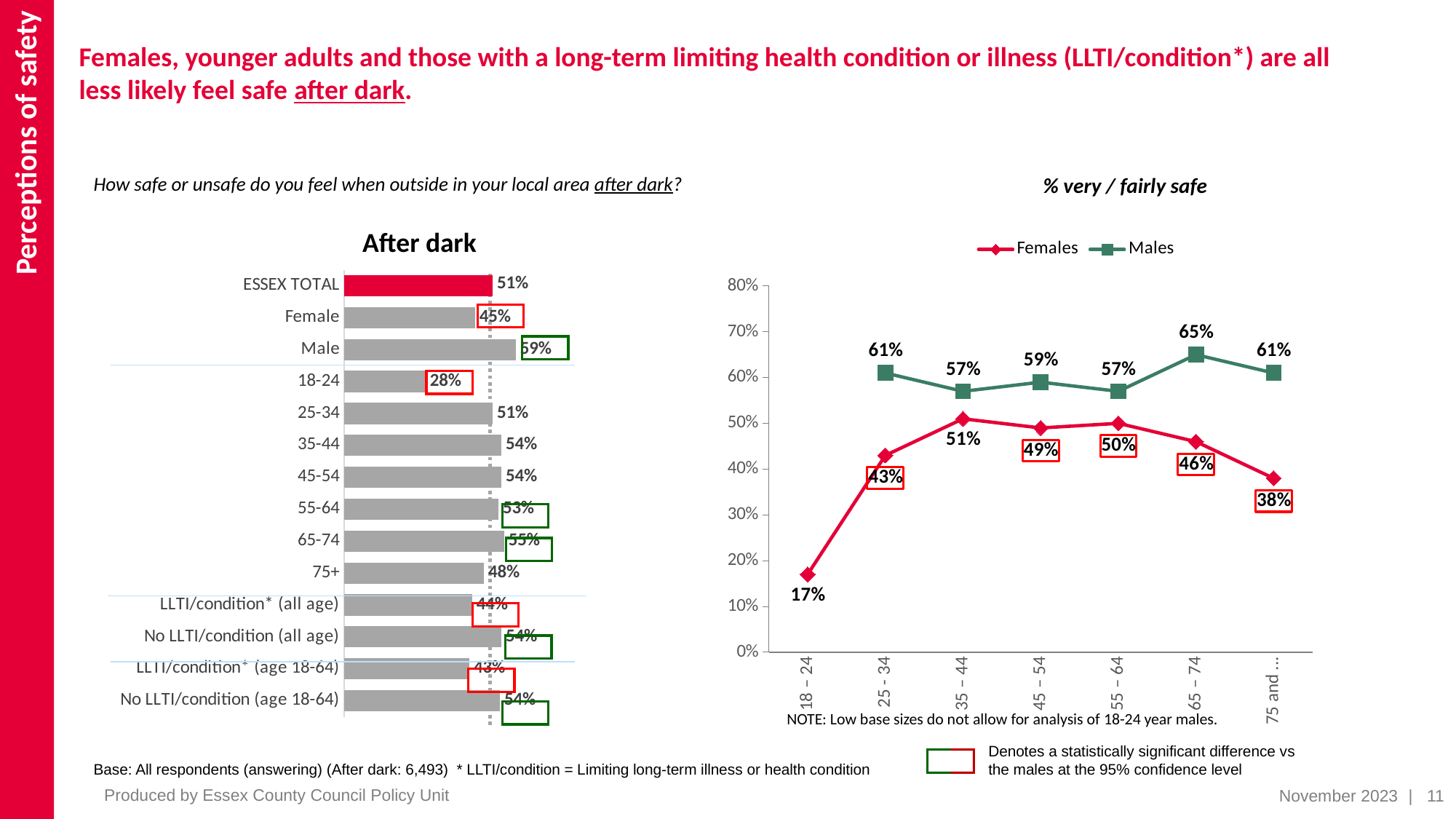
In the '% very / fairly safe' line chart, what is the Males value for the 65 – 74 age group? 65% In the '% very / fairly safe' line chart, what is the Females value for the 18 – 24 age group? 17% In the 'After dark' bar chart, what is the value for the 18-24 age group? 28% In the 'After dark' bar chart, which category has the lowest value? 18-24 In the 'After dark' bar chart, what is the value for ESSEX TOTAL? 51% In the '% very / fairly safe' line chart, which is larger for the 45 – 54 age group, Females or Males? Males In the 'After dark' bar chart, what is the difference between the Male and Female values? 14 percentage points What type of chart is the 'After dark' chart on the left? Bar chart In the 'After dark' bar chart, which category has the highest value? Male In the '% very / fairly safe' line chart, what is the difference between the Males and Females values for the 75 and over age group? 23 percentage points In the '% very / fairly safe' line chart, how many series does the legend list? 2 In the 'After dark' bar chart, how many categories are shown? 14